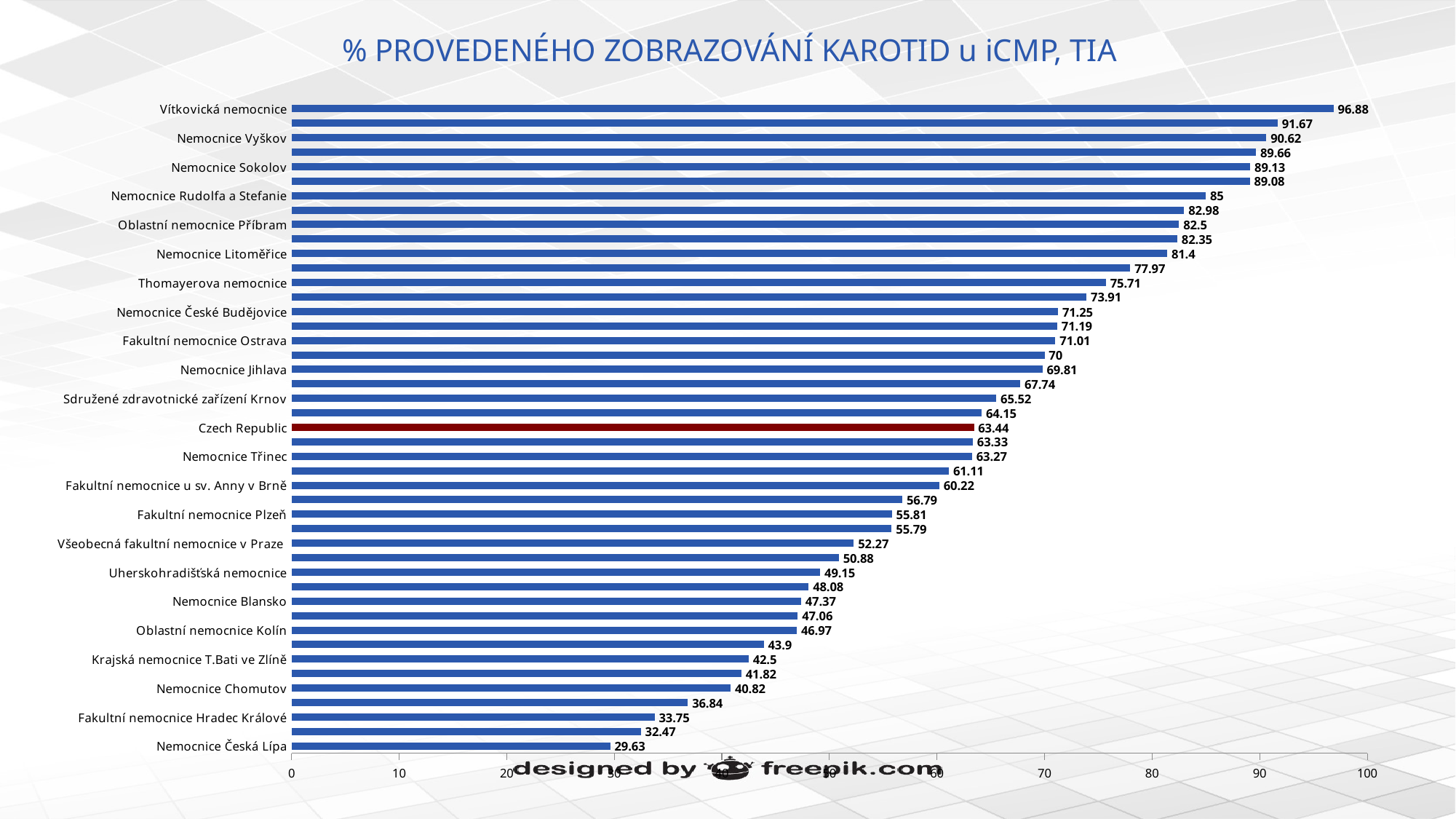
Which category has the lowest value? Nemocnice Česká Lípa Which is larger, the value for Nemocnice Jihlava or the value for Nemocnice Třinec? Nemocnice Jihlava Which category's bar is coloured differently (dark red) from the others? Czech Republic Which category has the highest value? Vítkovická nemocnice Is the value for Thomayerova nemocnice greater or less than 70? greater What is the value for Vítkovická nemocnice? 96.88 What is the value for Fakultní nemocnice Hradec Králové? 33.75 What is the difference between the values for Vítkovická nemocnice and Czech Republic? 33.44 What kind of chart is shown on the slide? bar chart What is the value for Czech Republic? 63.44 What is the title of the chart? % PROVEDENÉHO ZOBRAZOVÁNÍ KAROTID u iCMP, TIA What is the value for Nemocnice Rudolfa a Stefanie? 85